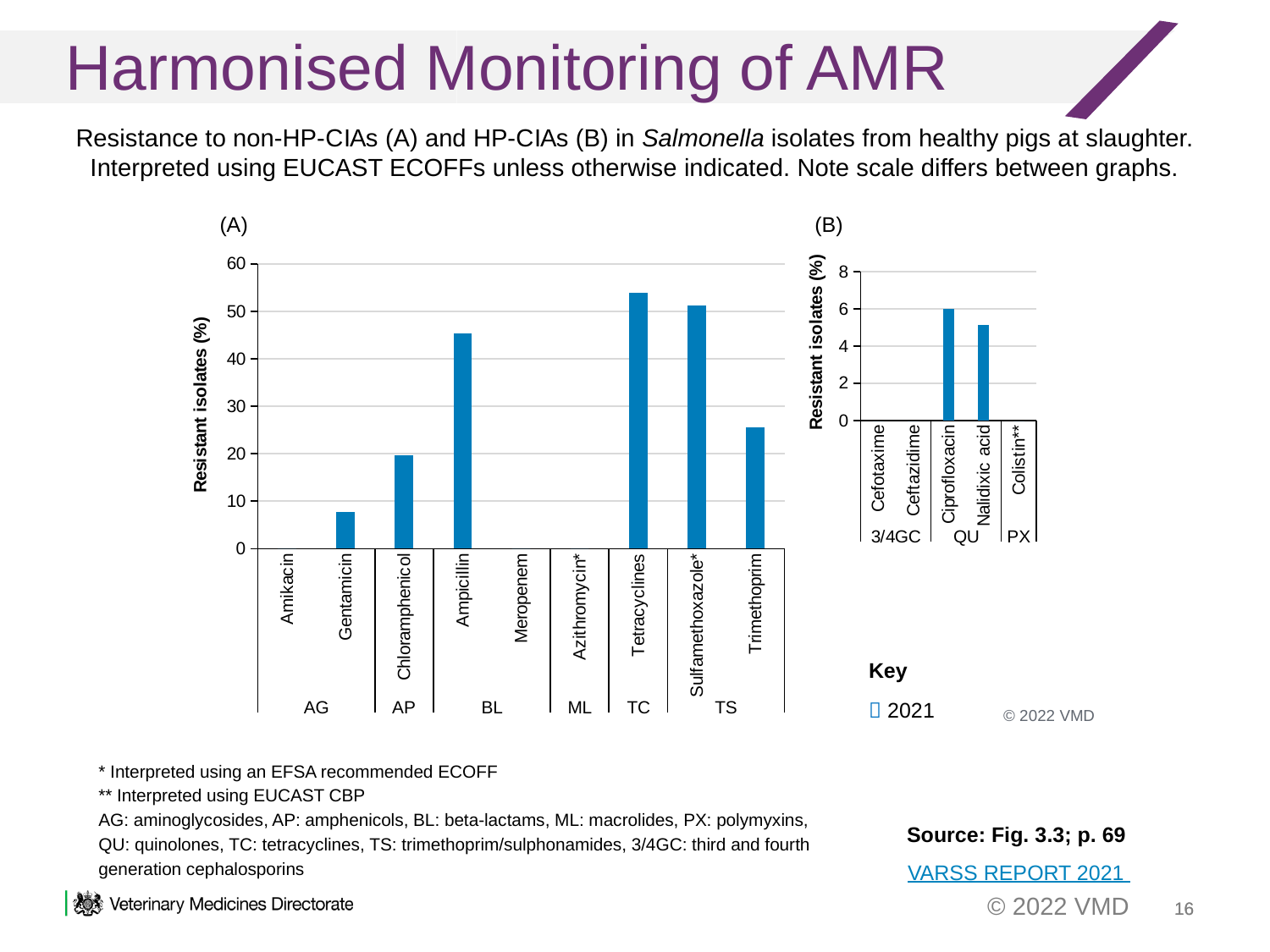
What is the y-axis label of chart (A)? Resistant isolates (%) What kind of chart is chart (A)? bar chart In chart (A), is the value for Gentamicin greater or less than 10? less In chart (A), which antimicrobial has the highest percentage of resistant isolates? Tetracyclines In chart (B), is the value for Ciprofloxacin greater or less than 4? greater In chart (A), is the value for Trimethoprim greater or less than 20? greater In chart (B), how many antimicrobials are shown on the x axis? 5 In chart (A), how many antimicrobials are shown on the x axis? 9 In chart (B), which has the larger value, Ciprofloxacin or Nalidixic acid? Ciprofloxacin In chart (A), which has the larger value, Chloramphenicol or Trimethoprim? Trimethoprim